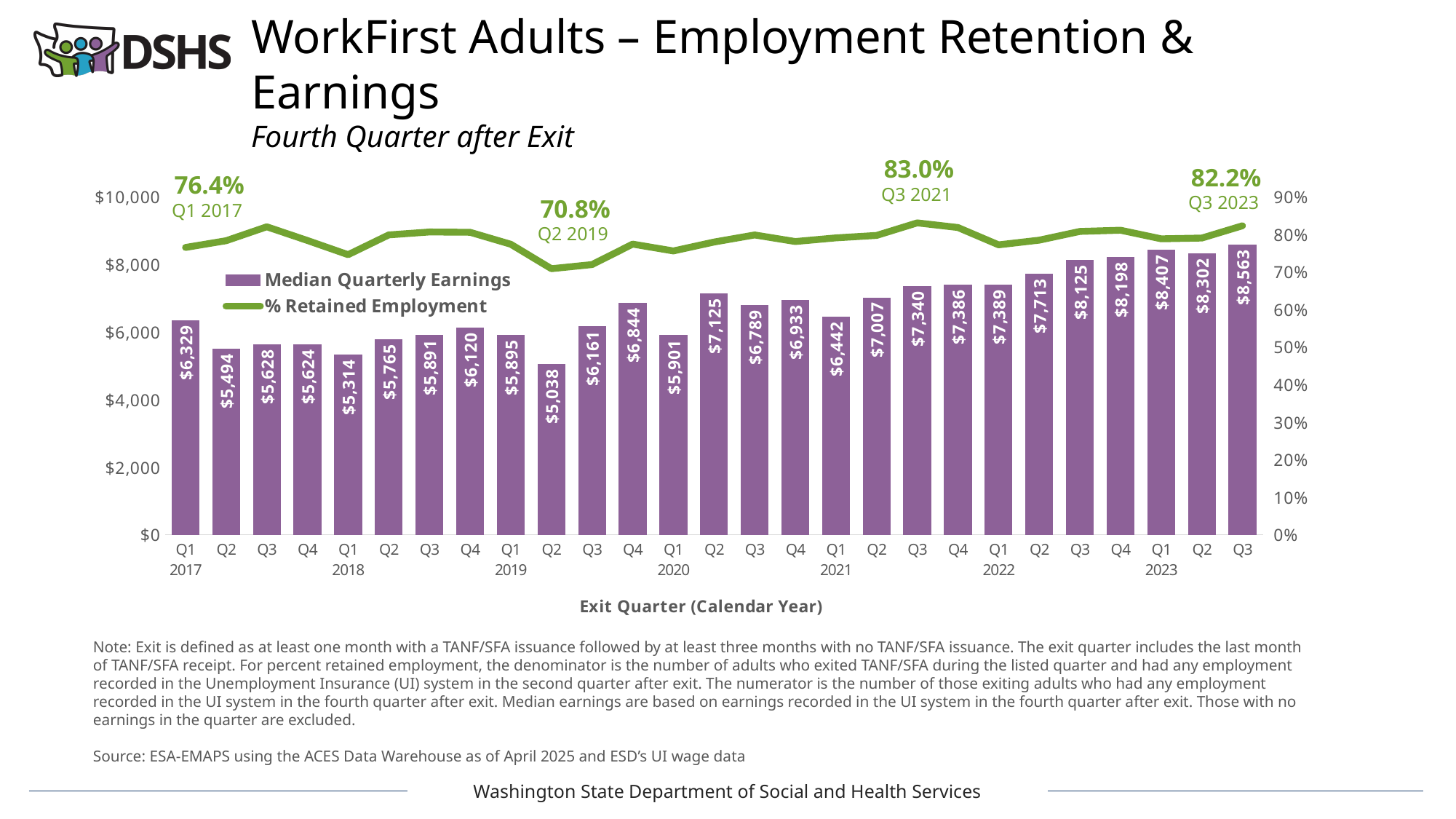
How many exit quarters are shown on the x axis? 27 Which exit quarter has the highest median quarterly earnings? Q3 2023 Which has higher median quarterly earnings, Q1 2023 or Q2 2023? Q1 2023 Which exit quarter has the lowest median quarterly earnings? Q2 2019 How many series does the legend list? 2 What is the difference in median quarterly earnings between Q3 2023 and Q2 2019? $3,525 What is the median quarterly earnings value for Q2 2020? $7,125 Do median quarterly earnings generally rise or fall from Q1 2021 to Q3 2023? rise What is the % retained employment labeled for Q3 2021? 83.0% What is the median quarterly earnings value for Q1 2017? $6,329 Is the % retained employment for Q2 2019 greater or less than 80%? less What kind of chart is this? Combination bar and line chart